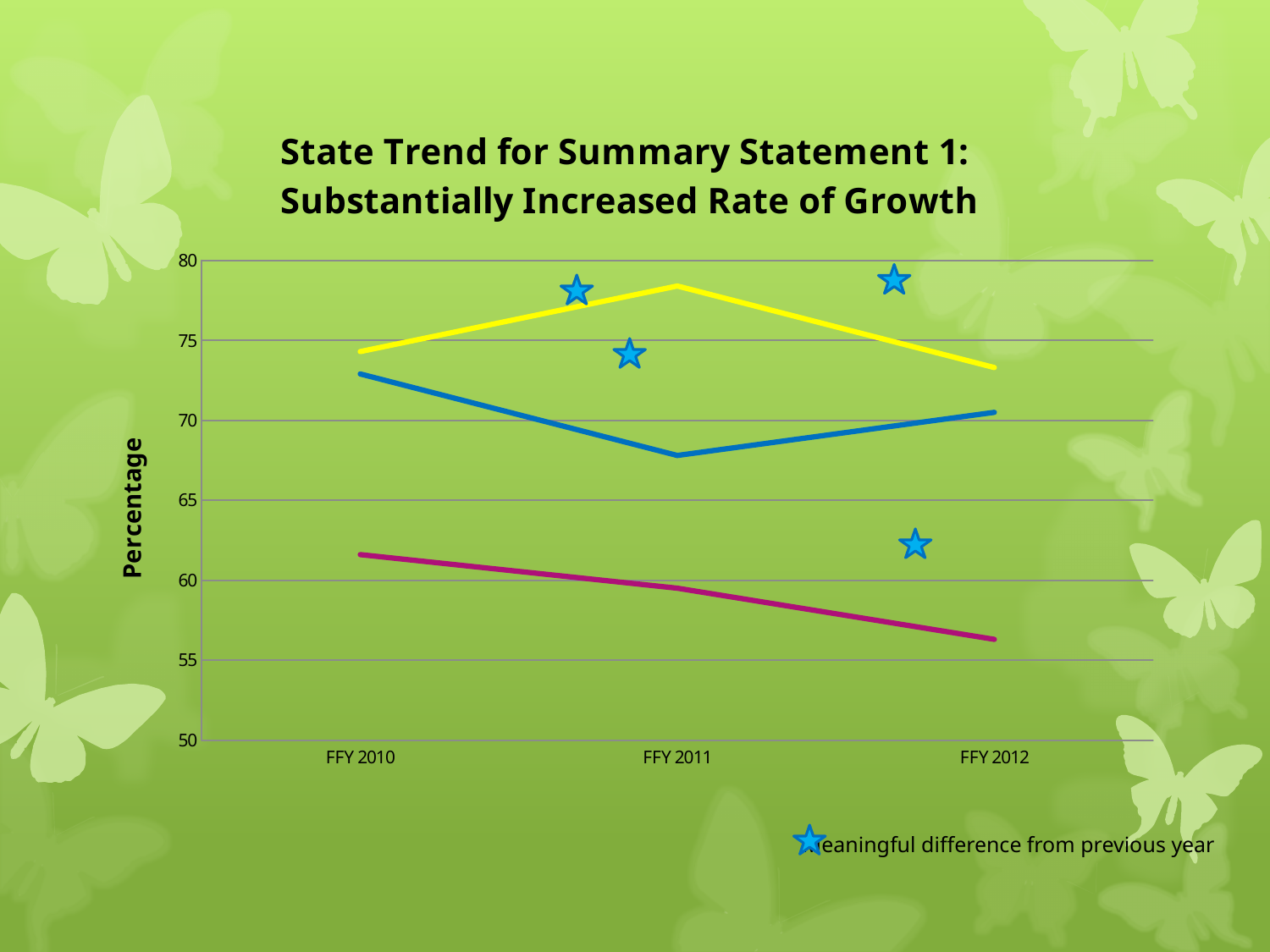
What is the label of the y axis? Percentage In which year does the yellow line reach its highest value? FFY 2011 Does the magenta line rise or fall from FFY 2010 to FFY 2012? Fall How many years are shown along the x axis of the chart? 3 In which year does the blue line reach its lowest value? FFY 2011 Is the value of the yellow line in FFY 2011 greater or less than 75? greater What kind of chart is shown on the slide? Line chart According to the note below the chart, what does a star symbol indicate? Meaningful difference from previous year In FFY 2012, which line has the larger value, the blue line or the magenta line? Blue line Is the value of the magenta line in FFY 2012 greater or less than 60? less In which year does the magenta line reach its lowest value? FFY 2012 Is the value of the blue line in FFY 2011 greater or less than 70? less